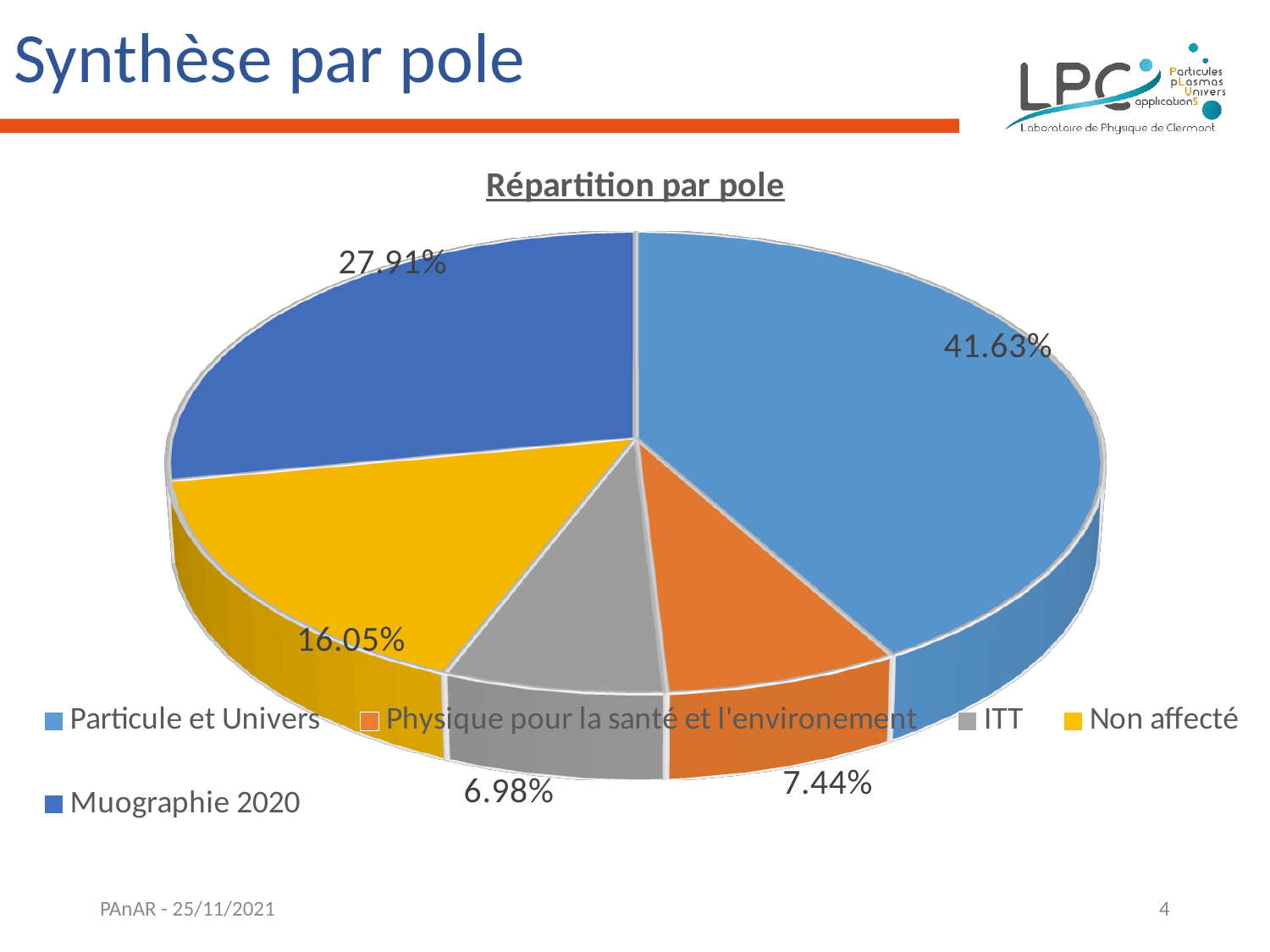
Which category has the largest share of the pie? Particule et Univers What is the title of the chart? Répartition par pole What kind of chart is shown on the slide? Pie chart Which category has the smallest share of the pie? ITT What share of the pie does Physique pour la santé et l'environement have? 7.44% What is the difference between the shares of Particule et Univers and Muographie 2020? 13.72% Which is larger, the share of Non affecté or the share of Physique pour la santé et l'environement? Non affecté What share of the pie does Non affecté have? 16.05% What share of the pie does Particule et Univers have? 41.63% What share of the pie does Muographie 2020 have? 27.91% What share of the pie does ITT have? 6.98% How many categories does the pie chart show? 5